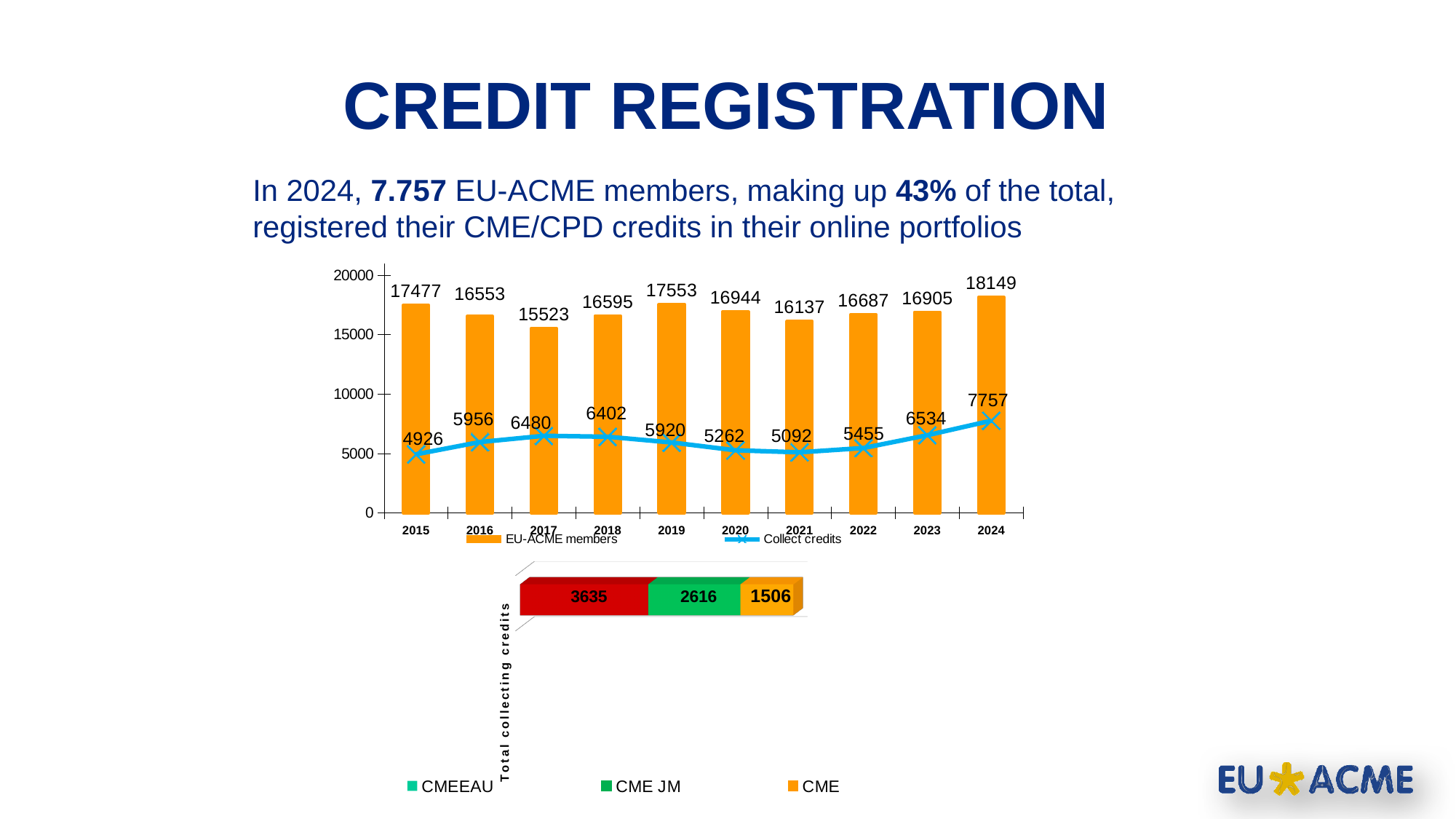
How many series does the legend of the top chart list? 2 In the top chart, by how much did Collect credits increase from 2023 to 2024? 1223 In the top chart, what is the value of EU-ACME members in 2024? 18149 In the top chart, how many members collected credits in 2015? 4926 In the bottom chart, what is the total of the stacked bar for Total collecting credits? 7757 In the bottom chart, what is the value of the CME segment? 1506 In the top chart, which year has the lowest number of EU-ACME members? 2017 In the top chart, which year has the highest number of EU-ACME members? 2024 In the top chart, which is larger: Collect credits in 2017 or in 2018? 2017 In the top chart, what is the difference between the EU-ACME members in 2024 and in 2015? 672 How many years are shown on the x axis of the top chart? 10 In the top chart, which year has the lowest value for Collect credits? 2015